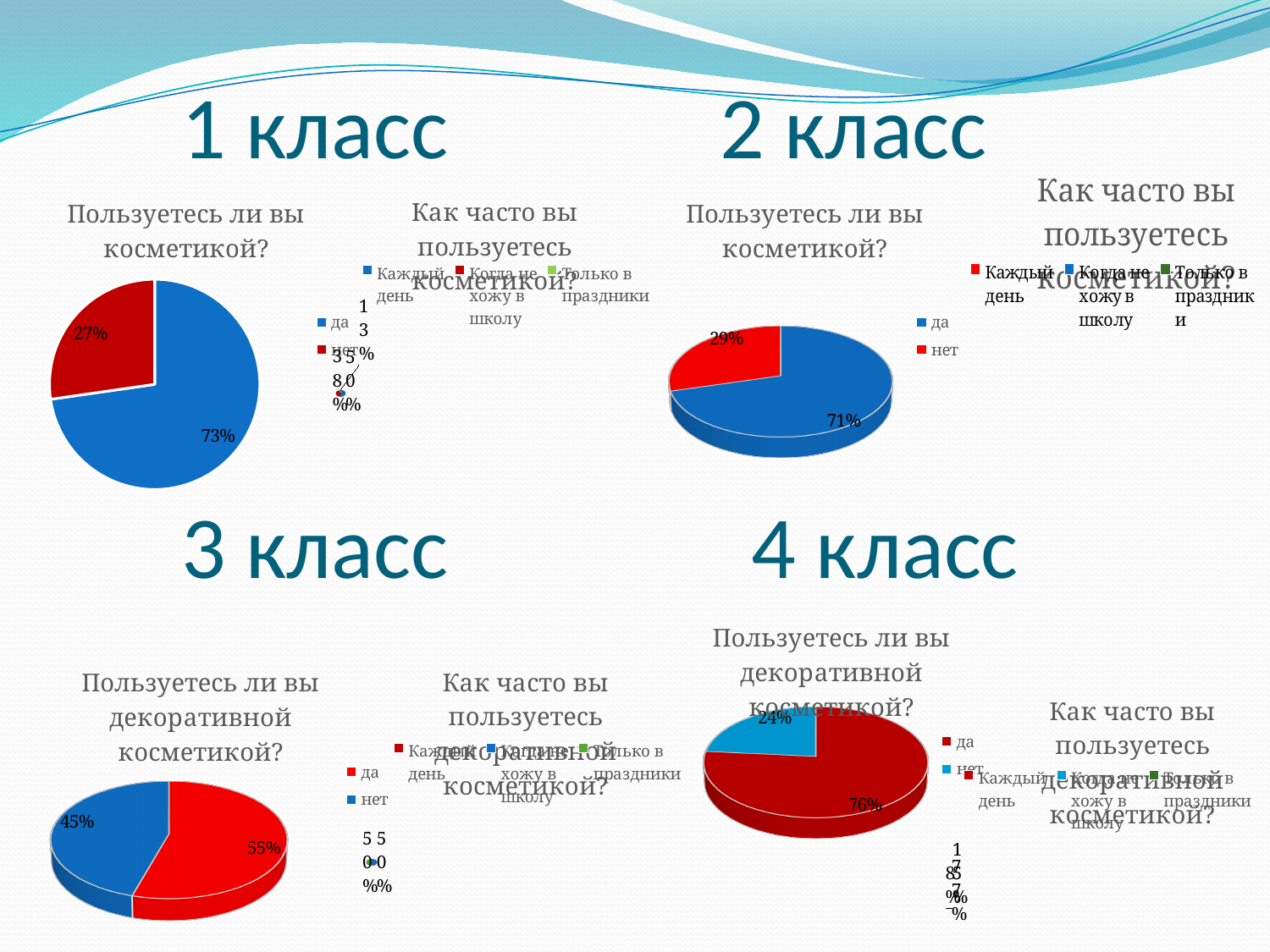
In the 1 класс pie chart "Пользуетесь ли вы косметикой?", what share answered "нет"? 27% In the 1 класс pie chart "Пользуетесь ли вы косметикой?", what is the difference in percentage points between "да" and "нет"? 46 In the 3 класс pie chart "Пользуетесь ли вы декоративной косметикой?", what share answered "да"? 55% In the 1 класс pie chart "Пользуетесь ли вы косметикой?", what share answered "да"? 73% In the 2 класс pie chart "Пользуетесь ли вы косметикой?", what share answered "нет"? 29% In the 2 класс pie chart "Пользуетесь ли вы косметикой?", what share answered "да"? 71% How many slices does the 2 класс pie chart "Пользуетесь ли вы косметикой?" have? 2 In the 4 класс pie chart "Пользуетесь ли вы декоративной косметикой?", what share answered "нет"? 24% In the 4 класс pie chart "Пользуетесь ли вы декоративной косметикой?", which answer has the larger slice? да What type of chart is used for "Пользуетесь ли вы косметикой?" in the 1 класс section? Pie chart In the 3 класс pie chart "Пользуетесь ли вы декоративной косметикой?", which answer has the smaller slice? нет Is the "да" share larger in the 1 класс pie chart or in the 2 класс pie chart "Пользуетесь ли вы косметикой?"? 1 класс